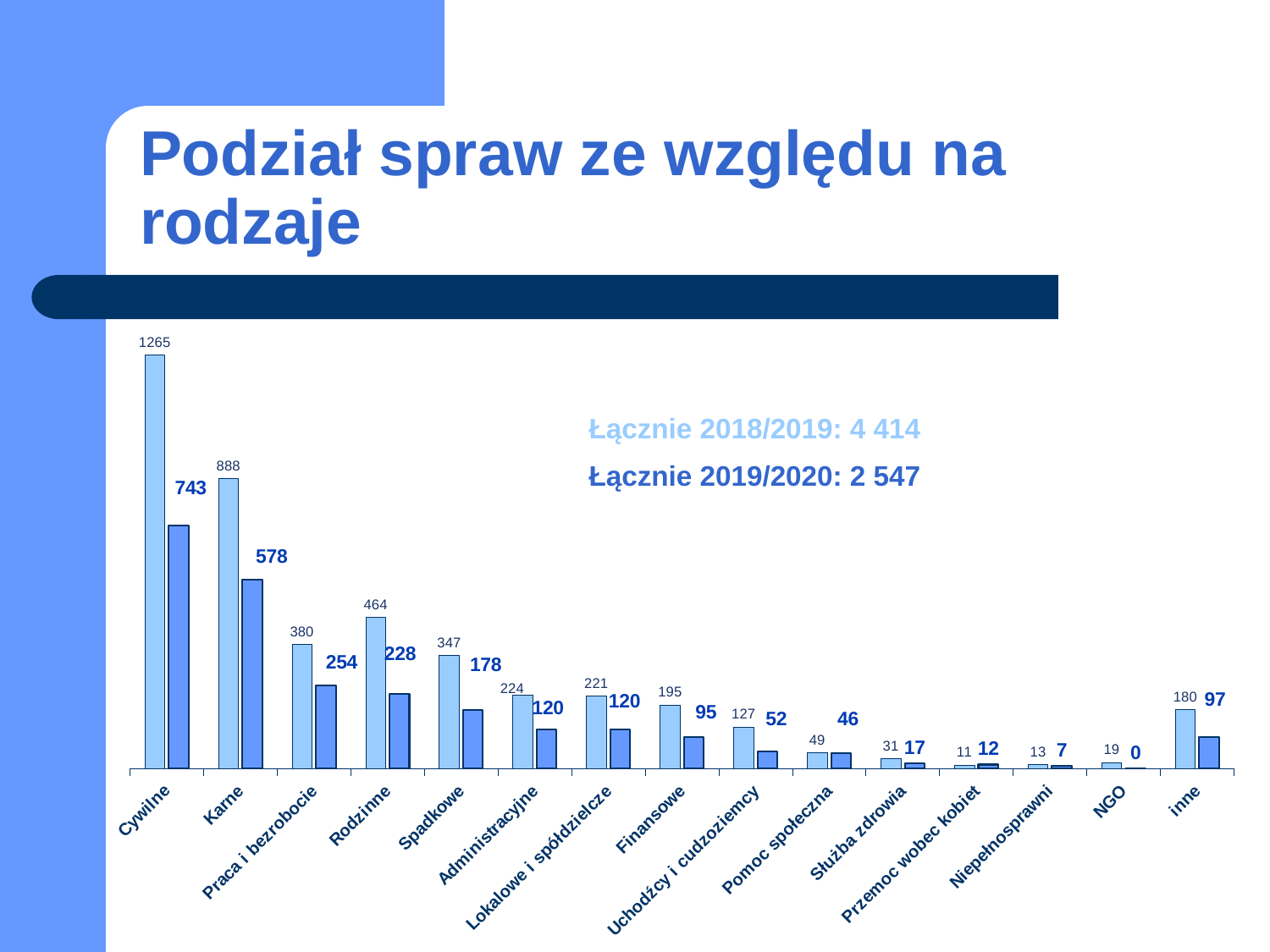
What is the value of the dark blue bar for Karne? 578 Which category has the highest light blue bar? Cywilne What is the difference between the light blue and dark blue bars for Cywilne? 522 How many categories are shown on the x axis of the chart? 15 What is the value of the light blue bar for Cywilne? 1265 Which category has the lowest dark blue bar? NGO What is the difference between the light blue bars for Karne and Praca i bezrobocie? 508 What type of chart is shown on the slide? bar chart What is the value of the dark blue bar for NGO? 0 What is the value of the light blue bar for Rodzinne? 464 What is the title of the slide containing the chart? Podział spraw ze względu na rodzaje Which is larger for Spadkowe: the light blue bar or the dark blue bar? the light blue bar